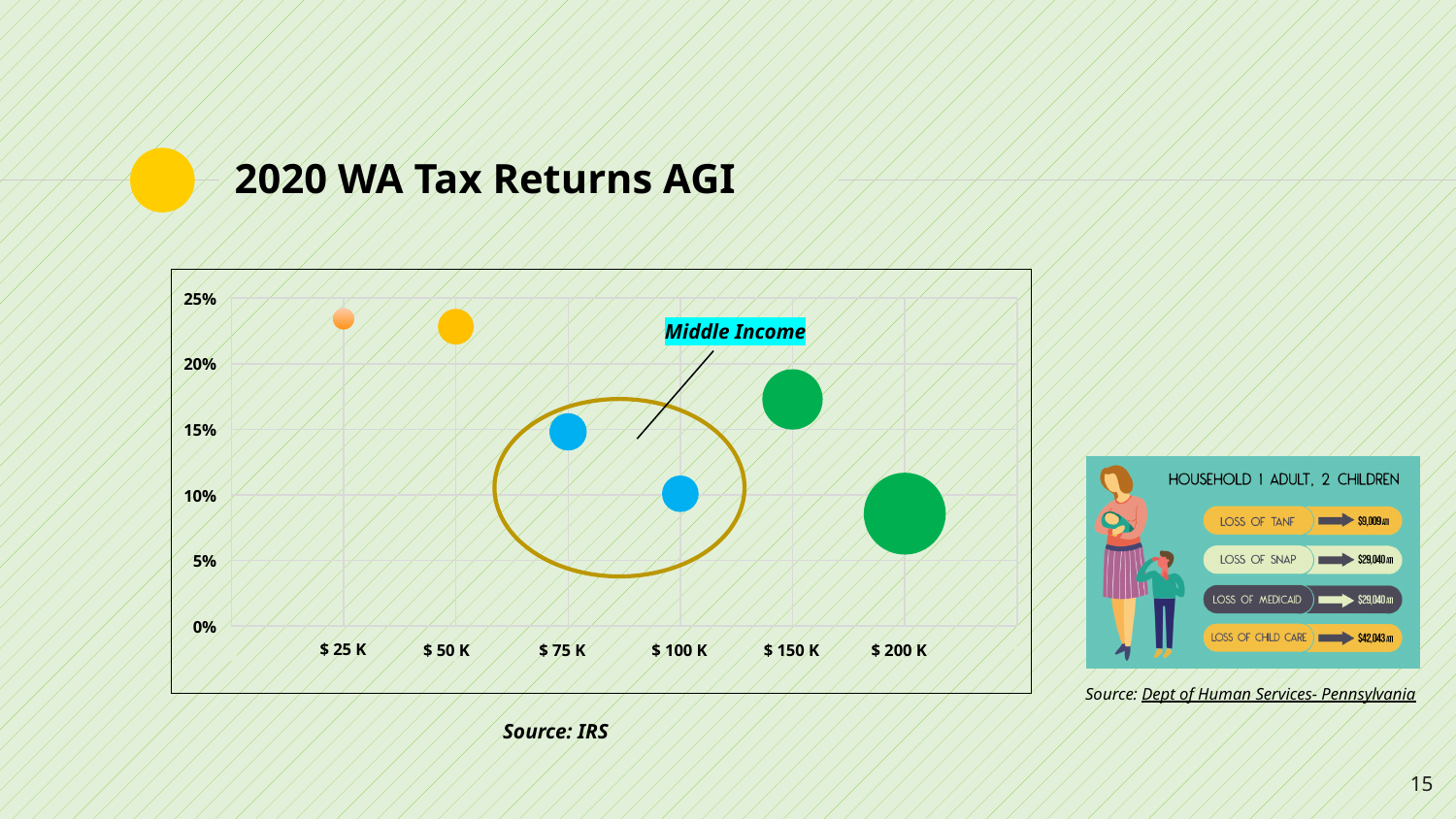
Is the value for $ 25 K greater or less than 20%? greater Which income categories are enclosed by the circle labelled "Middle Income"? $ 75 K and $ 100 K Is the value for $ 100 K greater or less than 15%? less Which has the larger value, $ 150 K or $ 200 K? $ 150 K Is the value for $ 50 K greater or less than 20%? greater Which has the larger value, $ 75 K or $ 100 K? $ 75 K How many bubbles (income categories) are plotted in the chart? 6 What source is cited below the chart? IRS What kind of chart is shown on the slide? bubble chart